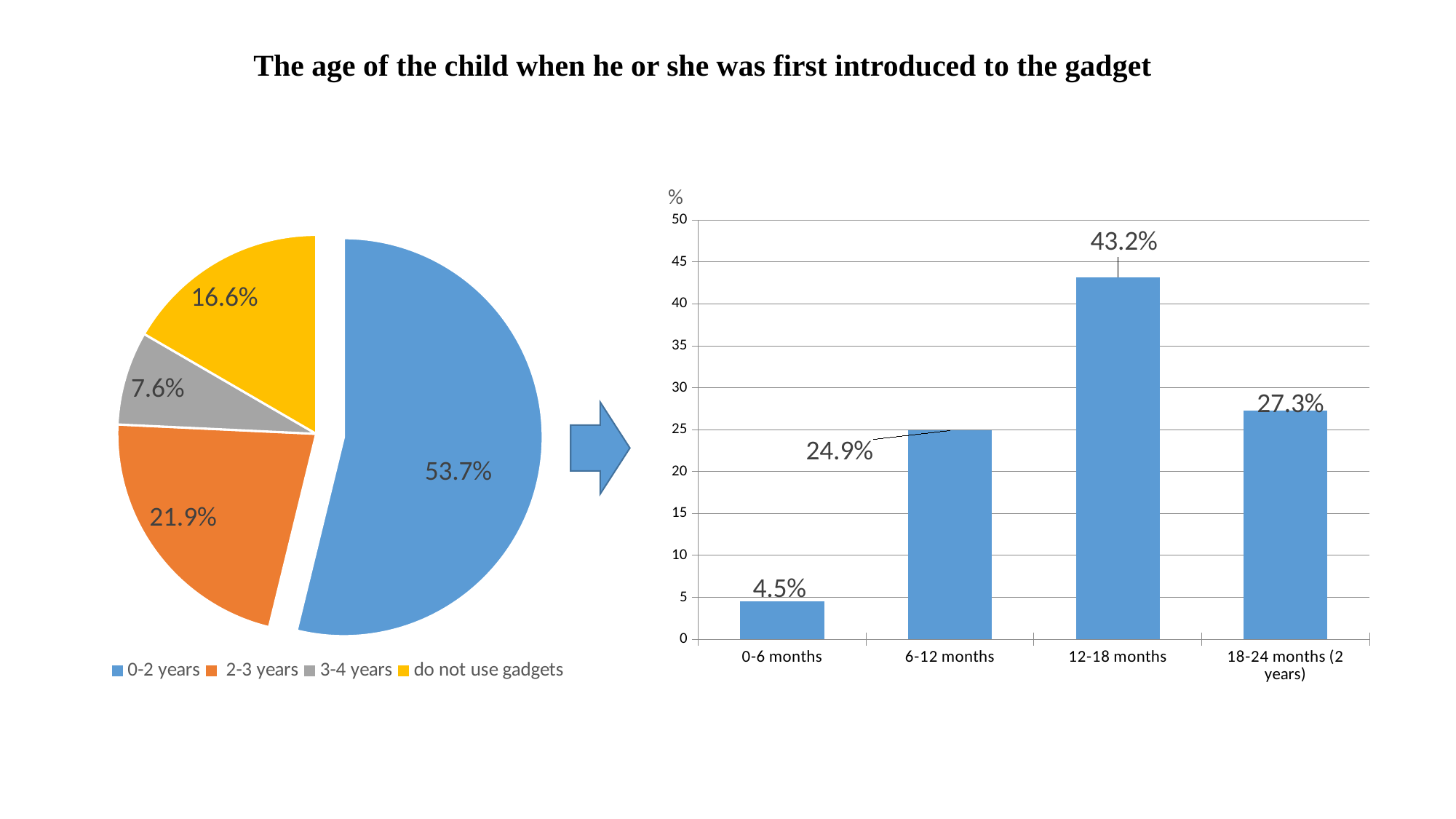
In the pie chart on the left, which category has the smallest slice? 3-4 years What type of chart is shown on the right side of the slide? Bar chart In the pie chart on the left, what share is shown for 2-3 years? 21.9% In the bar chart on the right, which category has the highest value? 12-18 months In the bar chart on the right, which is larger: 6-12 months or 18-24 months (2 years)? 18-24 months (2 years) In the bar chart on the right, what is the value for 0-6 months? 4.5% In the pie chart on the left, which category has the largest slice? 0-2 years In the pie chart on the left, what share is shown for 0-2 years? 53.7% In the pie chart on the left, how many categories does the legend list? 4 In the pie chart on the left, what is the difference between the 2-3 years slice and the do not use gadgets slice? 5.3% In the bar chart on the right, what is the difference between 12-18 months and 18-24 months (2 years)? 15.9% In the bar chart on the right, what is the value for 12-18 months? 43.2%